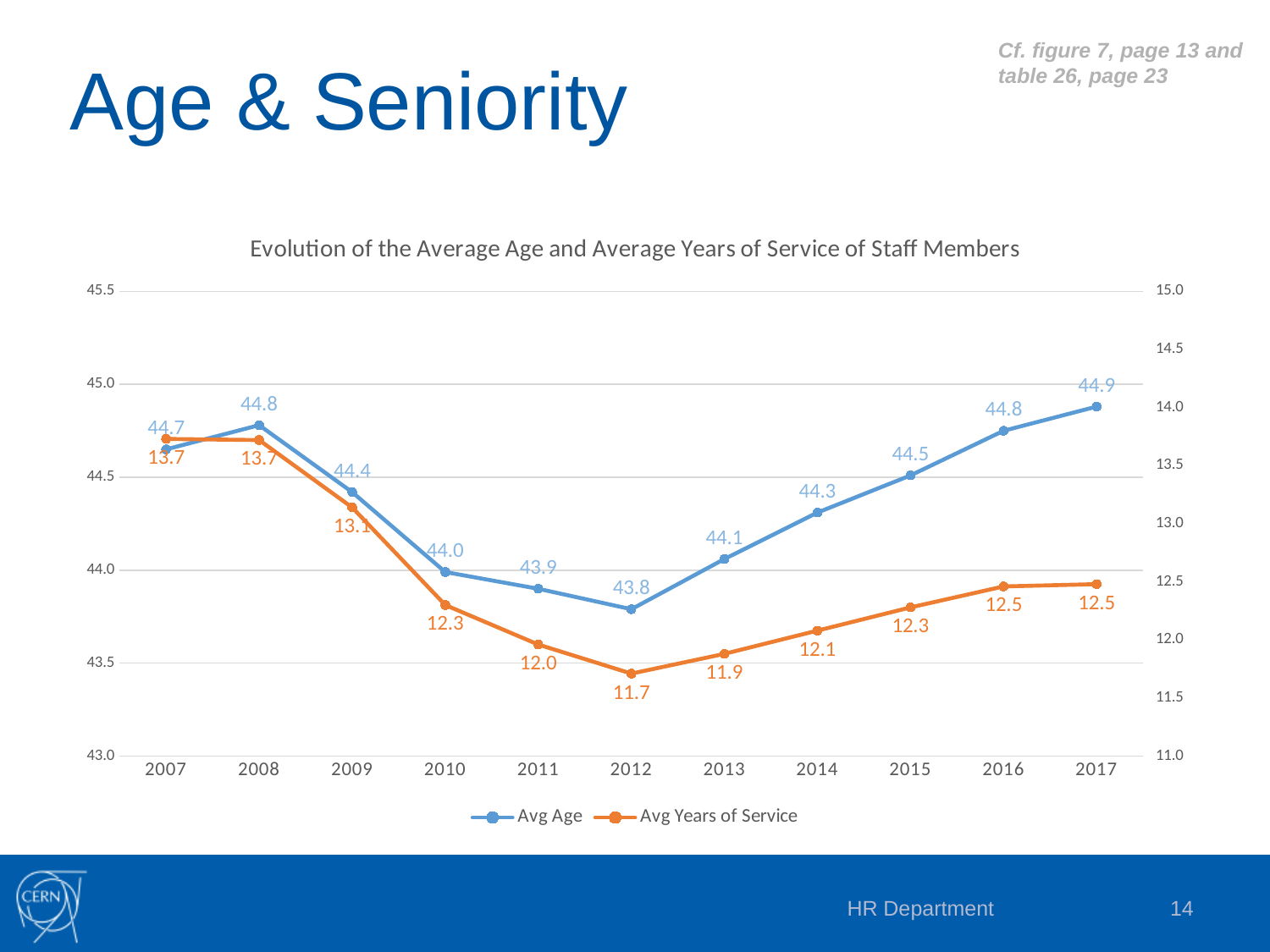
Does the Avg Age rise or fall from 2012 to 2017? Rise What is the difference between the Avg Age in 2017 and in 2012? 1.1 What is the Avg Age value for 2012? 43.8 What is the Avg Years of Service value for 2010? 12.3 In which year is the Avg Years of Service lowest? 2012 How many years are shown on the x axis? 11 What kind of chart is shown on the slide? Line chart Which is larger, the Avg Years of Service in 2009 or in 2015? 2009 What is the difference between the Avg Years of Service in 2007 and in 2012? 2.0 How many series does the legend list? 2 In which year is the Avg Age highest? 2017 What is the Avg Age value for 2017? 44.9